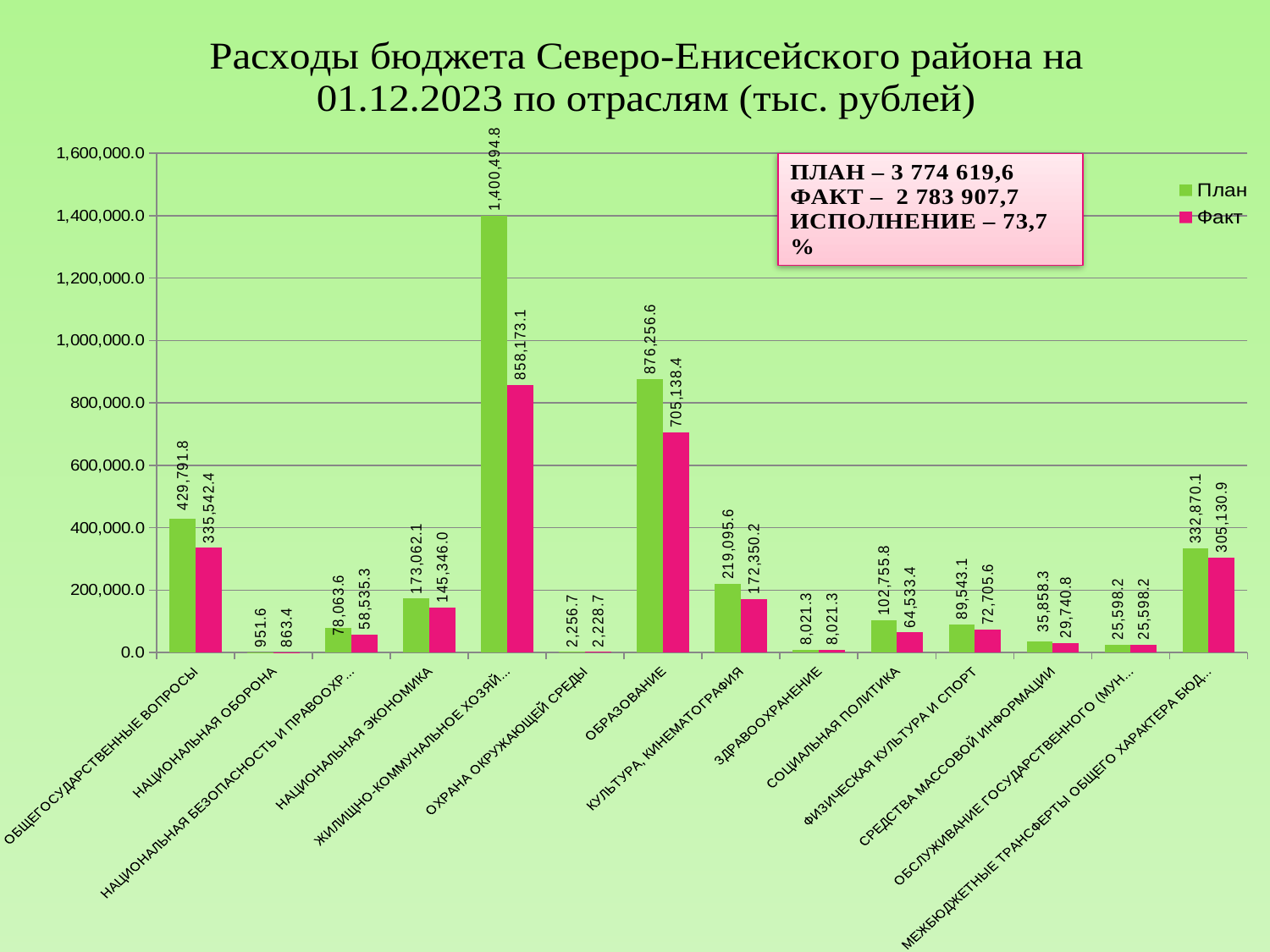
What is the difference between the План and Факт values for ОБРАЗОВАНИЕ? 171,118.2 What is the difference between the План and Факт values for ЖИЛИЩНО-КОММУНАЛЬНОЕ ХОЗЯЙ...? 542,321.7 Which category has the highest План value? ЖИЛИЩНО-КОММУНАЛЬНОЕ ХОЗЯЙ... How many categories are shown on the x axis? 14 Which category has the lowest Факт value? НАЦИОНАЛЬНАЯ ОБОРОНА What colour are the Факт bars? pink What is the Факт value for СОЦИАЛЬНАЯ ПОЛИТИКА? 64,533.4 How many series does the legend list? 2 Which is larger: the Факт value for ОБЩЕГОСУДАРСТВЕННЫЕ ВОПРОСЫ or the Факт value for МЕЖБЮДЖЕТНЫЕ ТРАНСФЕРТЫ ОБЩЕГО ХАРАКТЕРА БЮД...? ОБЩЕГОСУДАРСТВЕННЫЕ ВОПРОСЫ What is the Факт value for НАЦИОНАЛЬНАЯ ЭКОНОМИКА? 145,346.0 What type of chart is shown on the slide? bar chart What is the План value for ОБРАЗОВАНИЕ? 876,256.6